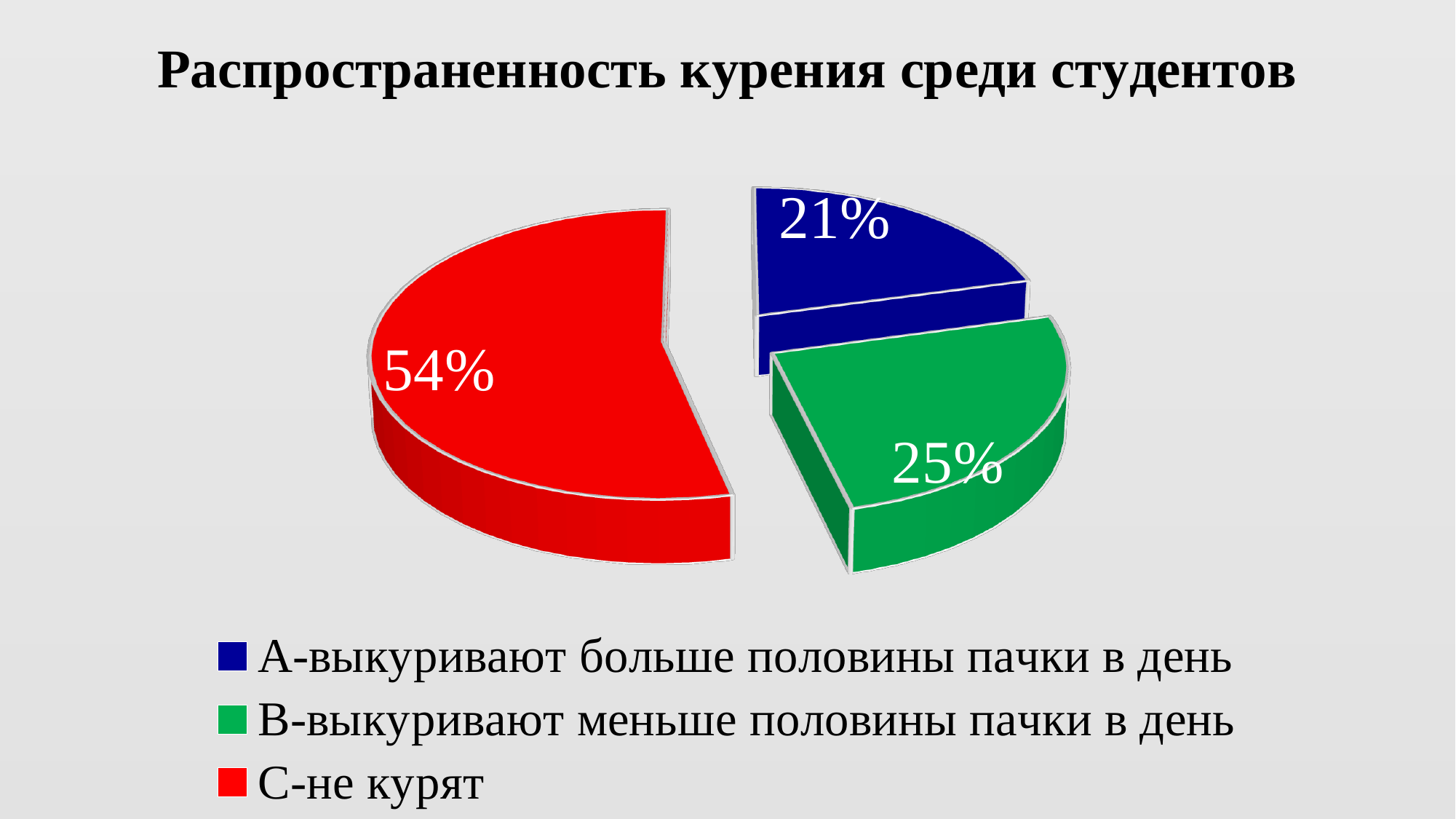
What share of the pie is labelled 'В-выкуривают меньше половины пачки в день'? 25% What share of the pie is labelled 'С-не курят'? 54% What is the difference in percentage points between 'С-не курят' and 'В-выкуривают меньше половины пачки в день'? 29 Which category has the smallest slice of the pie? А-выкуривают больше половины пачки в день What is the chart's title? Распространенность курения среди студентов How many slices does the pie chart have? 3 Which category has the largest slice of the pie? С-не курят Which is larger: the slice for 'В-выкуривают меньше половины пачки в день' or the slice for 'А-выкуривают больше половины пачки в день'? В-выкуривают меньше половины пачки в день What colour is the slice for 'С-не курят'? Red What kind of chart is shown on the slide? Pie chart What share of the pie is labelled 'А-выкуривают больше половины пачки в день'? 21% How many entries does the legend list? 3